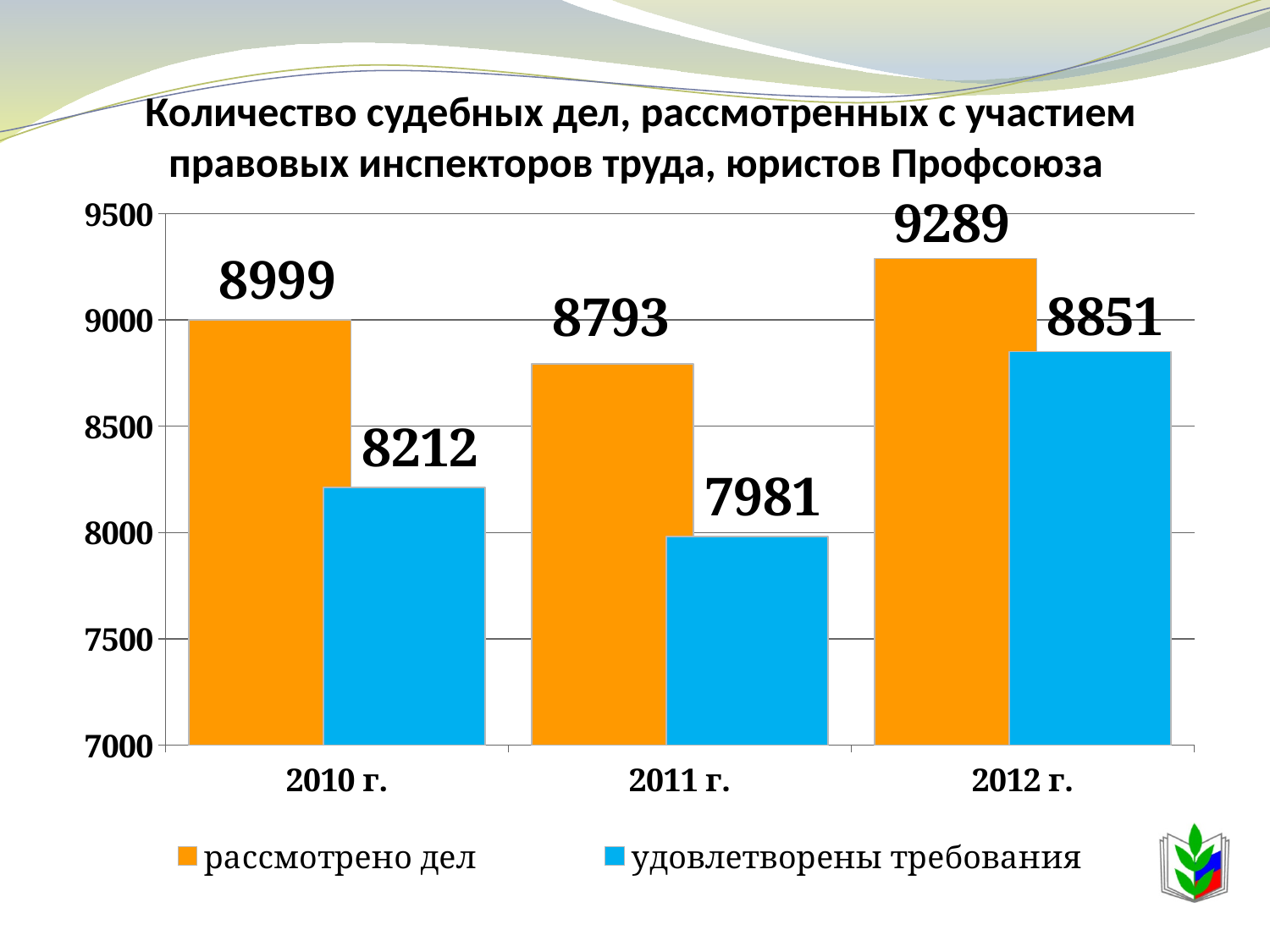
What kind of chart is shown on the slide? bar chart What is the value of "удовлетворены требования" for 2011 г.? 7981 In which year is "удовлетворены требования" lowest? 2011 г. What is the value of "рассмотрено дел" for 2010 г.? 8999 How many years are shown on the x axis? 3 Is the value of "рассмотрено дел" for 2011 г. greater or less than 9000? less How many series does the legend list? 2 Which is larger: "удовлетворены требования" in 2010 г. or in 2011 г.? 2010 г. What is the difference between "рассмотрено дел" and "удовлетворены требования" in 2012 г.? 438 In which year is "рассмотрено дел" highest? 2012 г. What is the value of "удовлетворены требования" for 2012 г.? 8851 What is the difference between "рассмотрено дел" in 2012 г. and in 2011 г.? 496